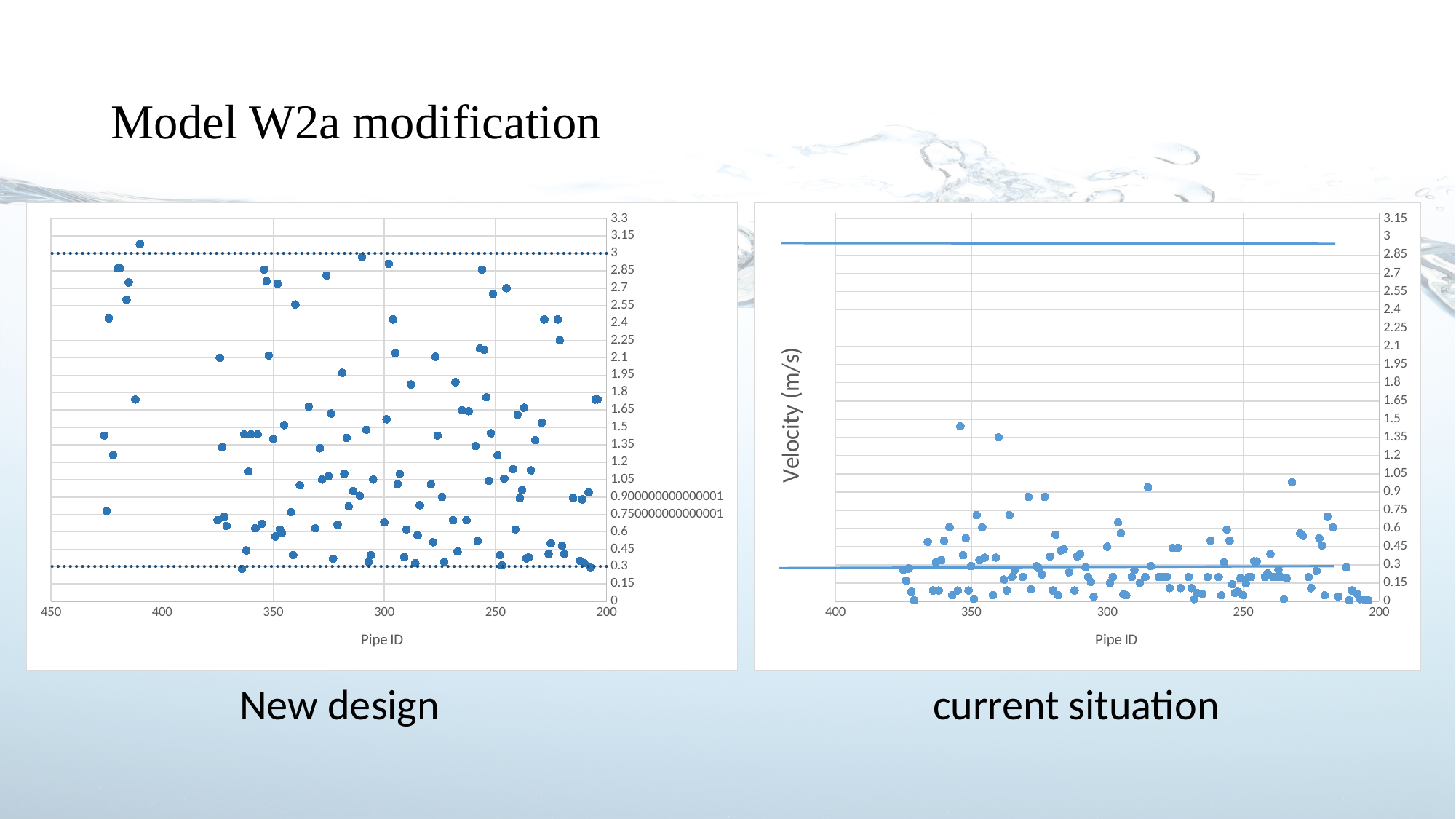
In the 'current situation' chart, is the highest plotted point greater or less than 1.8? less In the 'current situation' chart, is the lower horizontal reference line greater or less than 0.45? less In the 'New design' chart, what is the title of the horizontal axis? Pipe ID In the 'current situation' chart, is the upper horizontal reference line greater or less than 2.7? greater What kind of chart is the 'current situation' chart on the right? Scatter chart Which chart has the higher maximum plotted value, 'New design' or 'current situation'? New design In the 'current situation' chart, what is the title of the vertical axis? Velocity (m/s) What kind of chart is the 'New design' chart on the left? Scatter chart